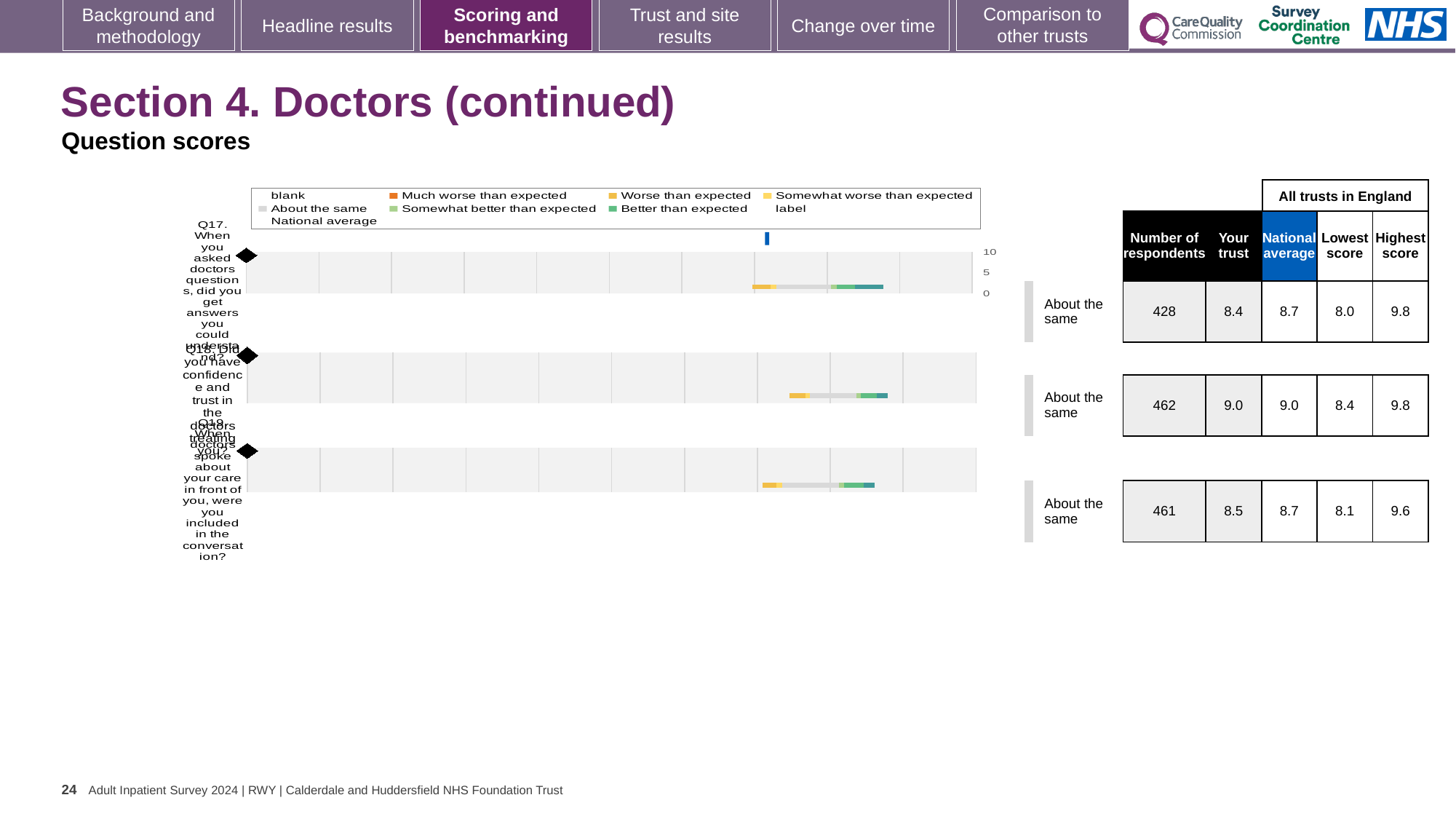
What is the highest tick value shown on the chart's axis? 10 In the table beside the chart, what is the national average for Q18 (Did you have confidence and trust in the doctors treating you?)? 9.0 In the chart legend, what colour represents 'About the same'? grey In the table beside the chart, how many respondents answered Q18? 462 For Q17, which is larger: the 'Your trust' score or the national average? National average Which question has the lowest 'Your trust' score in the table beside the chart? Q17 In the table beside the chart, what is the highest score for Q19 (When doctors spoke about your care in front of you, were you included in the conversation?)? 9.6 How many questions (categories) are plotted in the chart? 3 In the table beside the chart, what is the 'Your trust' score for Q17 (When you asked doctors questions, did you get answers you could understand?)? 8.4 What kind of chart is shown on the slide? bar chart For Q17, what is the difference between the highest score and the lowest score in the table beside the chart? 1.8 Which question has the highest 'Your trust' score in the table beside the chart? Q18